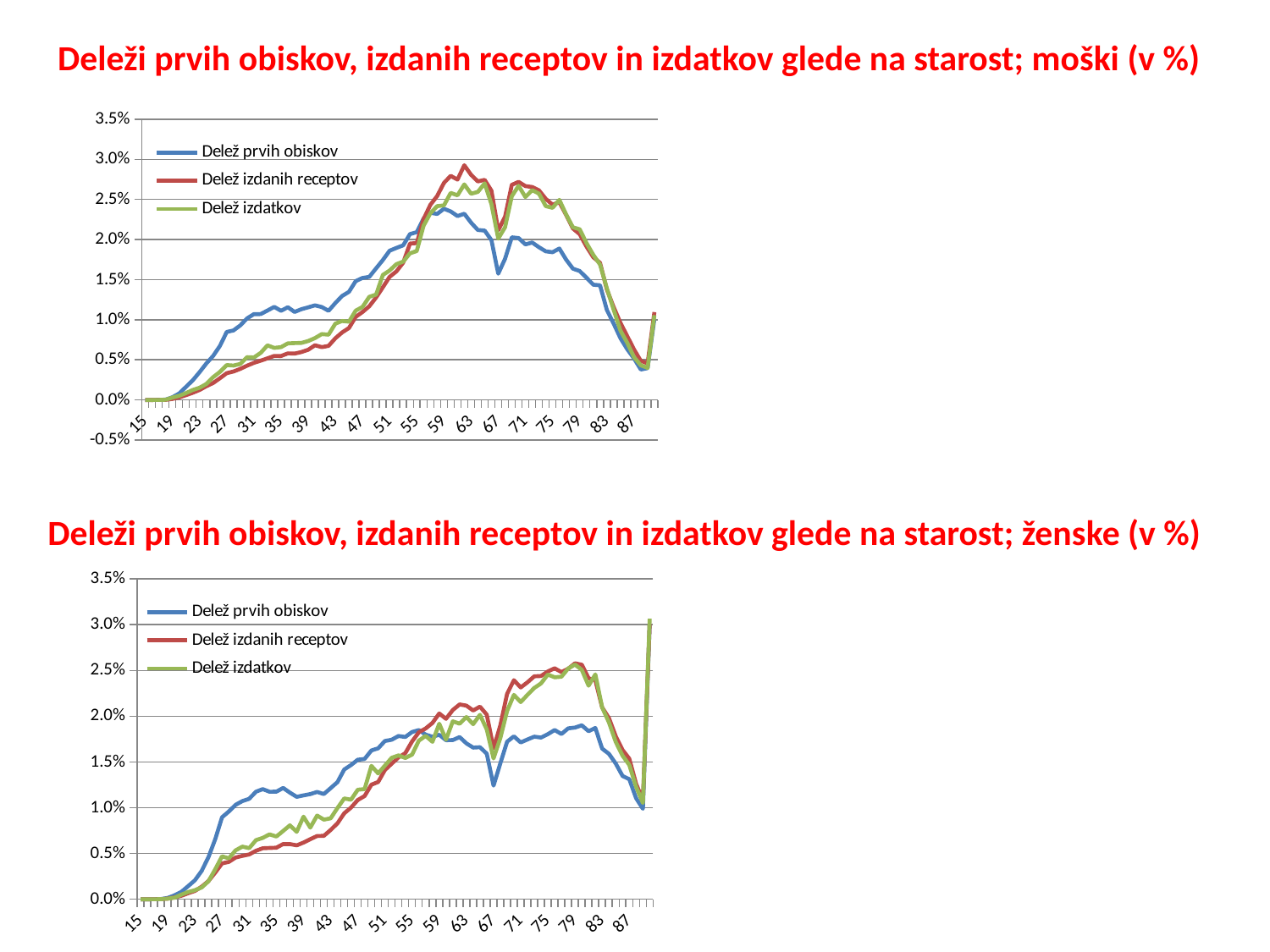
How many series does the legend of the bottom chart (ženske) list? 3 In the top chart (moški), at age 63, which is larger: Delež izdanih receptov or Delež prvih obiskov? Delež izdanih receptov In the top chart (moški), which series is shown in blue? Delež prvih obiskov In the top chart (moški), is the value of Delež prvih obiskov at age 59 greater or less than 2.0%? greater In the bottom chart (ženske), does Delež izdanih receptov rise or fall between ages 79 and 87? fall In the bottom chart (ženske), which series is shown in green? Delež izdatkov In the top chart (moški), does Delež prvih obiskov rise or fall between ages 15 and 27? rise In the bottom chart (ženske), is the value of Delež prvih obiskov at age 35 greater or less than 1.0%? greater In the top chart (moški), at age 31, which is larger: Delež prvih obiskov or Delež izdanih receptov? Delež prvih obiskov In the top chart (moški), is the value of Delež izdanih receptov at age 23 greater or less than 0.5%? less What kind of chart is the top chart (moški)? line chart